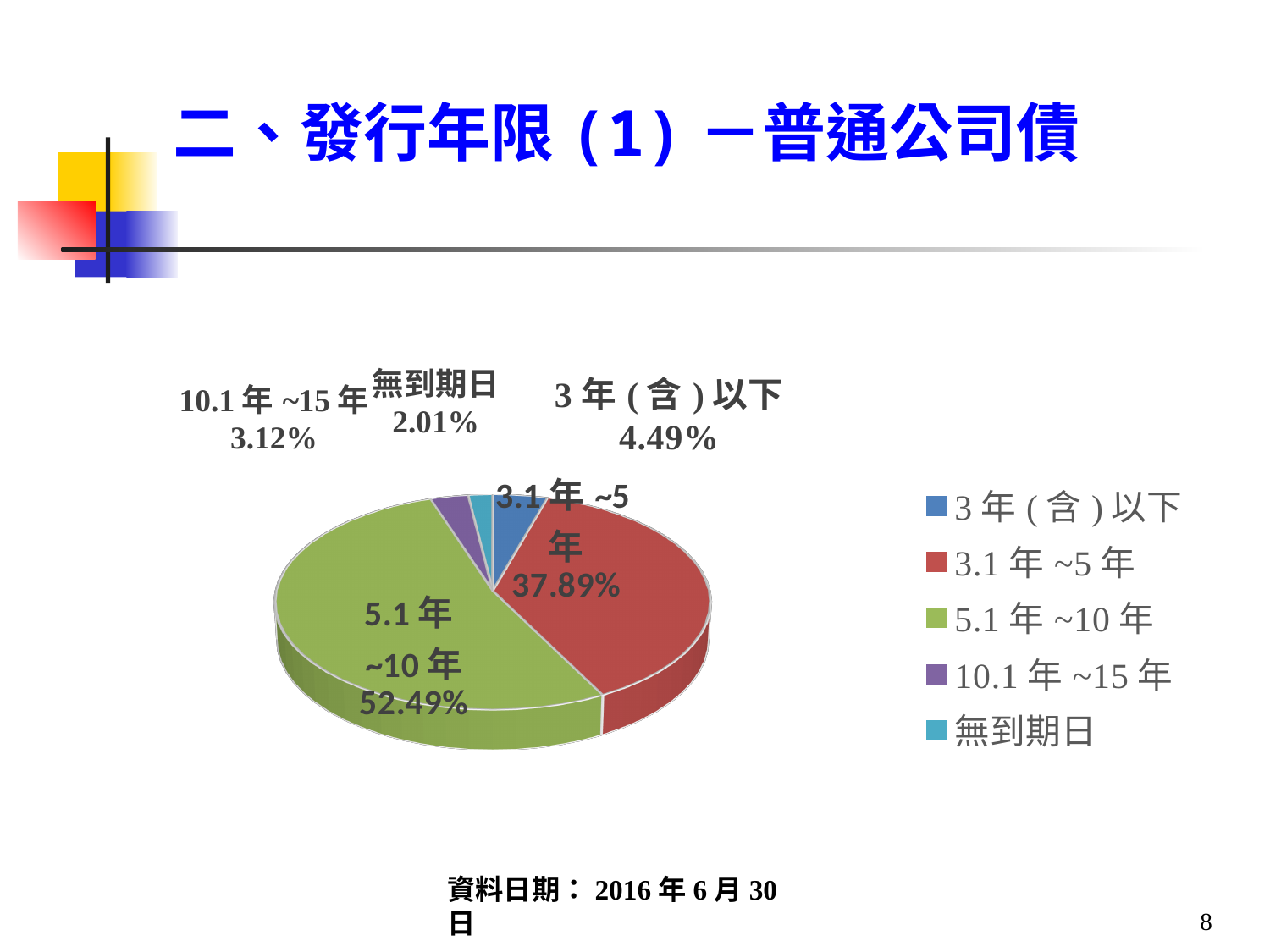
What is the difference between the shares of 5.1年~10年 and 3.1年~5年? 14.60% What is the value shown for 10.1年~15年? 3.12% What is the value shown for 無到期日? 2.01% Which category has the largest share of the pie? 5.1年~10年 Which is larger, the share for 3年(含)以下 or the share for 10.1年~15年? 3年(含)以下 What colour is the 5.1年~10年 slice in the pie chart? green What is the value shown for 3年(含)以下? 4.49% Which category has the smallest share of the pie? 無到期日 How many slices does the pie chart have? 5 What share of the pie does the 5.1年~10年 slice represent? 52.49% What share of the pie does the 3.1年~5年 slice represent? 37.89% What type of chart is shown on the slide? pie chart